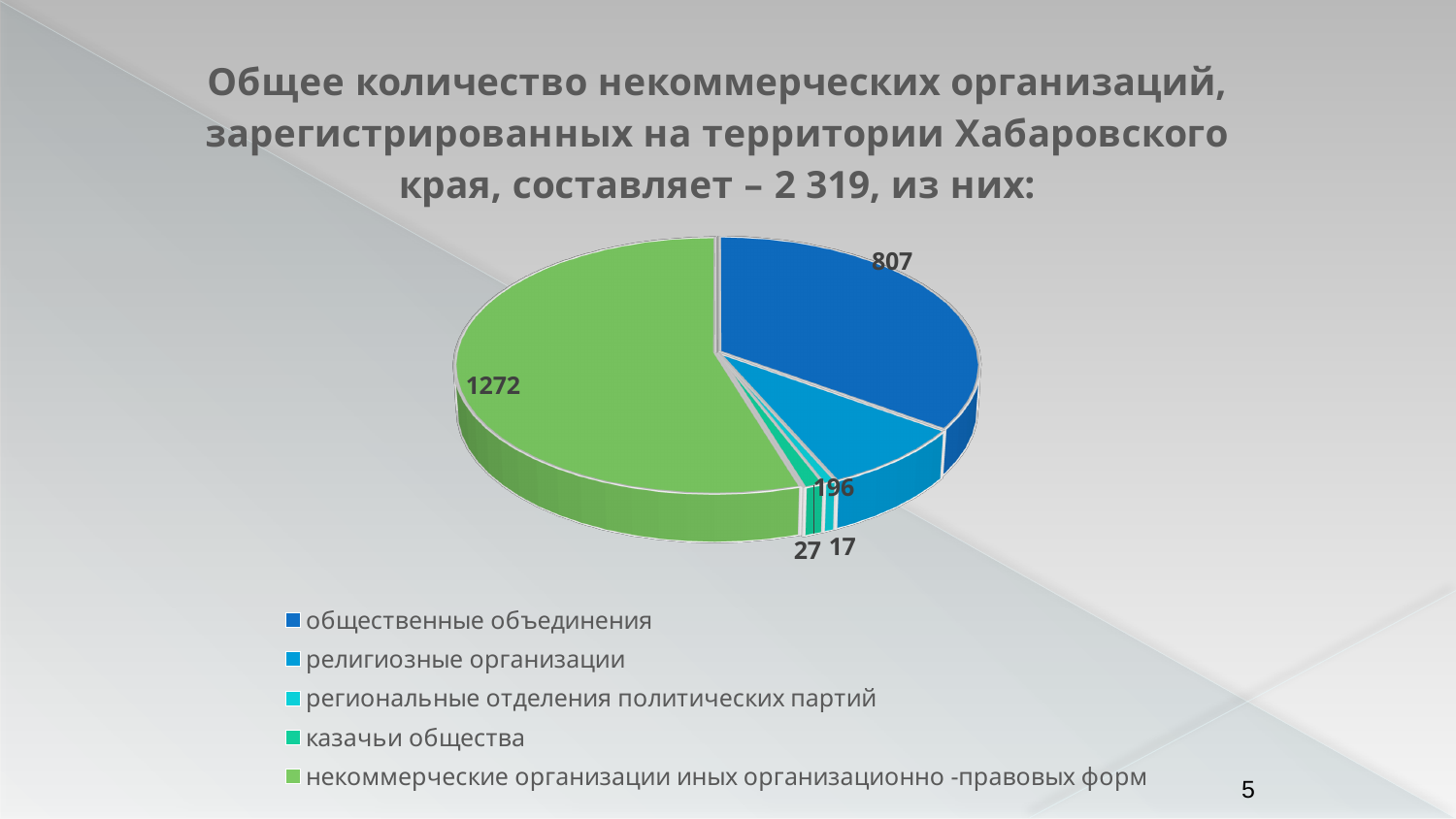
What is the value for религиозные организации? 196 What is the value for казачьи общества? 27 What kind of chart is shown on the slide? pie chart Which is larger, the value for общественные объединения or the value for религиозные организации? общественные объединения How many entries does the legend list? 5 What is the value for региональные отделения политических партий? 17 What is the value for общественные объединения? 807 How many slices does the pie chart have? 5 What is the difference between the values for некоммерческие организации иных организационно-правовых форм and общественные объединения? 465 Which category has the largest slice of the pie? некоммерческие организации иных организационно-правовых форм What is the value for некоммерческие организации иных организационно-правовых форм? 1272 Which category has the smallest slice of the pie? региональные отделения политических партий